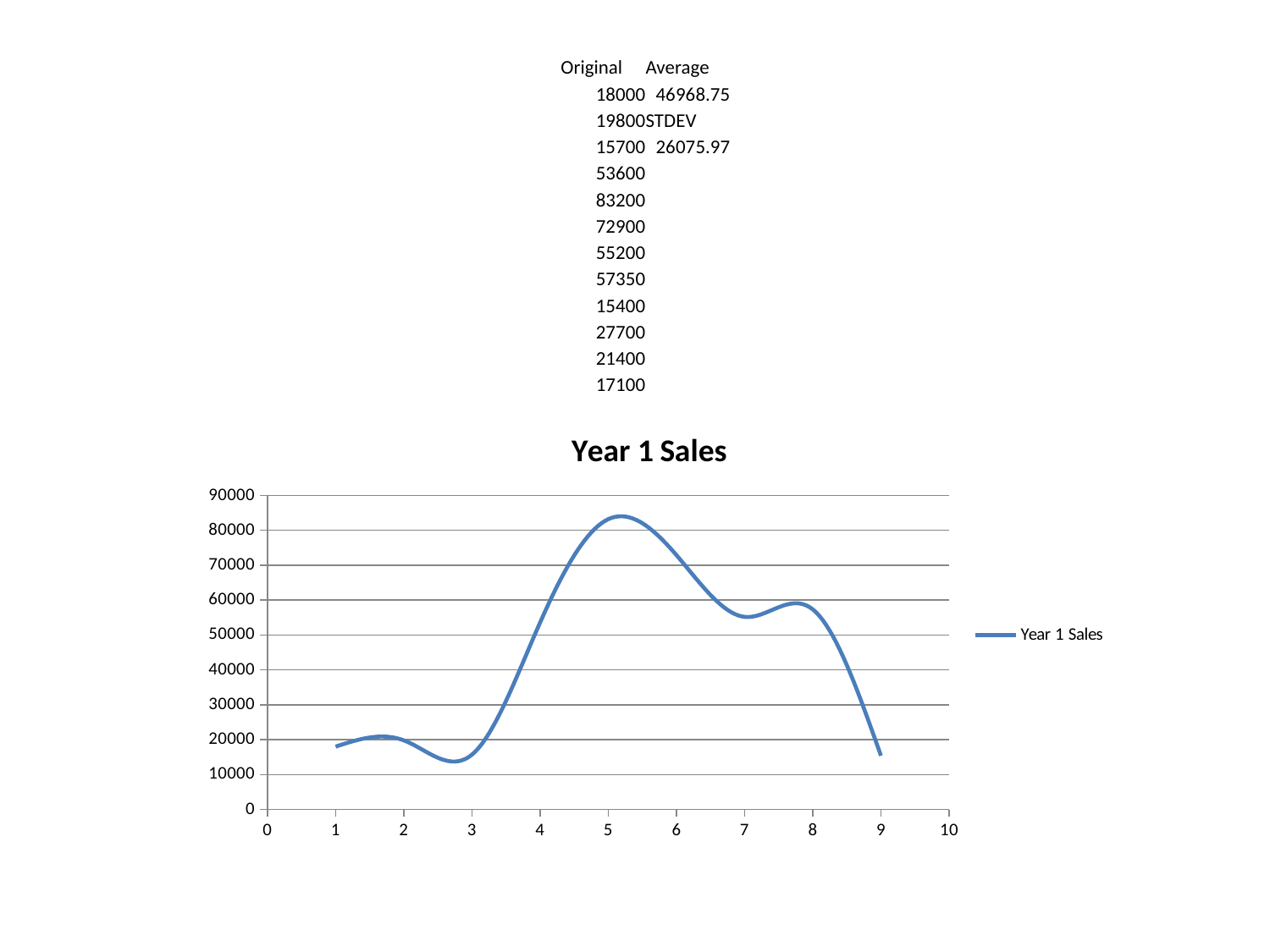
Which is larger, the value at x = 5 or the value at x = 6? x = 5 Is the value at x = 6 greater or less than 70000? greater How many data points are plotted on the line? 9 Is the value at x = 5 greater or less than 80000? greater What is the title of the chart? Year 1 Sales Is the value at x = 9 greater or less than 20000? less Does the line rise or fall between x = 5 and x = 9? fall At which x value does the line reach its highest point? 5 What kind of chart is shown on the slide? line chart How many series does the legend list? 1